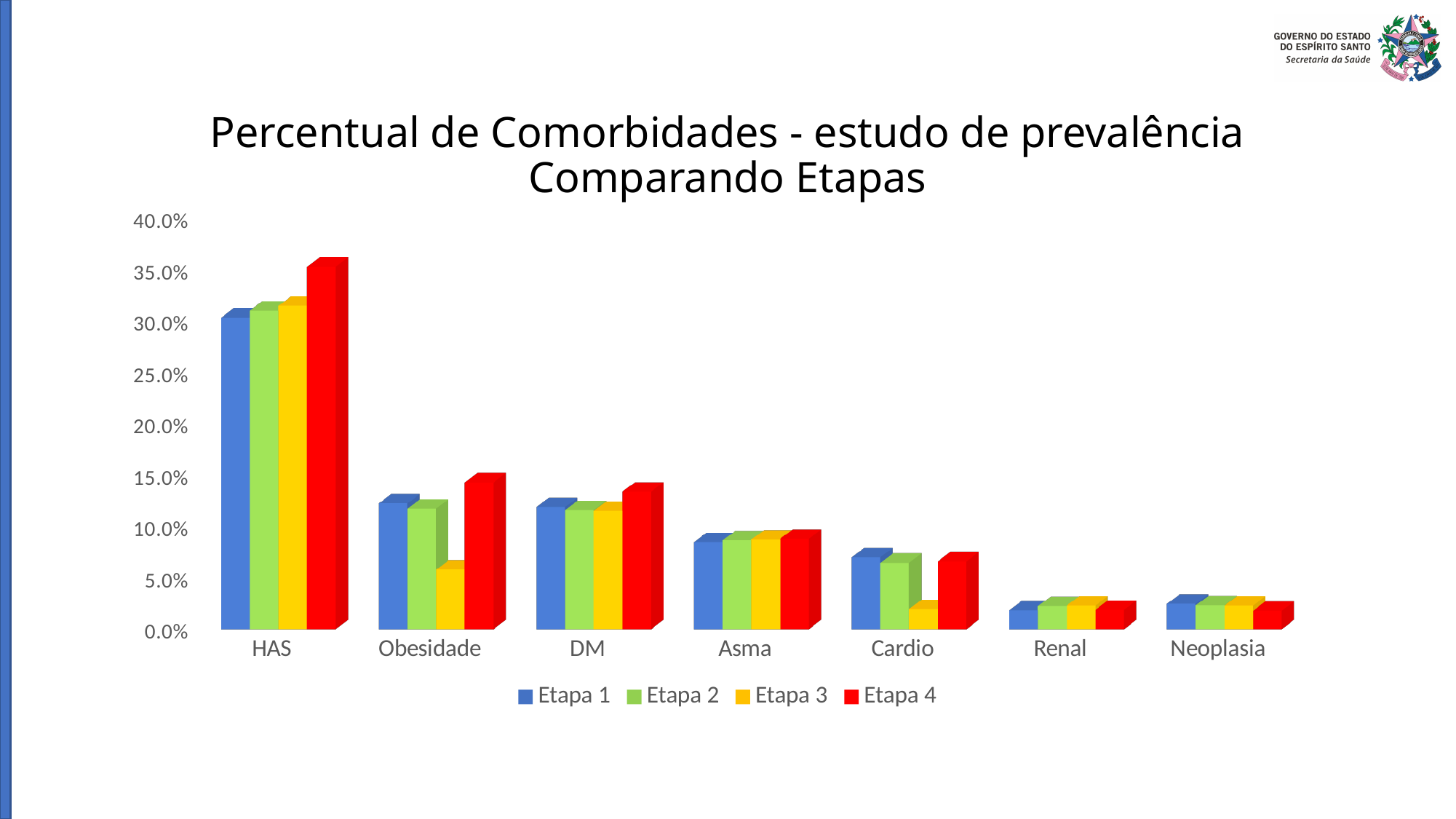
Is the Etapa 3 value for Cardio greater or less than 5.0%? less Is the Etapa 3 value for Obesidade greater or less than 10.0%? less How many series does the legend list? 4 Which category has the highest Etapa 4 value? HAS Which is larger: the Etapa 4 value for Obesidade or the Etapa 3 value for Obesidade? Etapa 4 What kind of chart is shown on the slide? bar chart Within the Cardio category, which Etapa has the lowest value? Etapa 3 What is the title of the chart? Percentual de Comorbidades - estudo de prevalência Comparando Etapas Within the HAS category, which Etapa has the highest value? Etapa 4 Within the Obesidade category, which Etapa has the lowest value? Etapa 3 How many categories are shown on the x axis of the chart? 7 Is the Etapa 4 value for HAS greater or less than 30.0%? greater